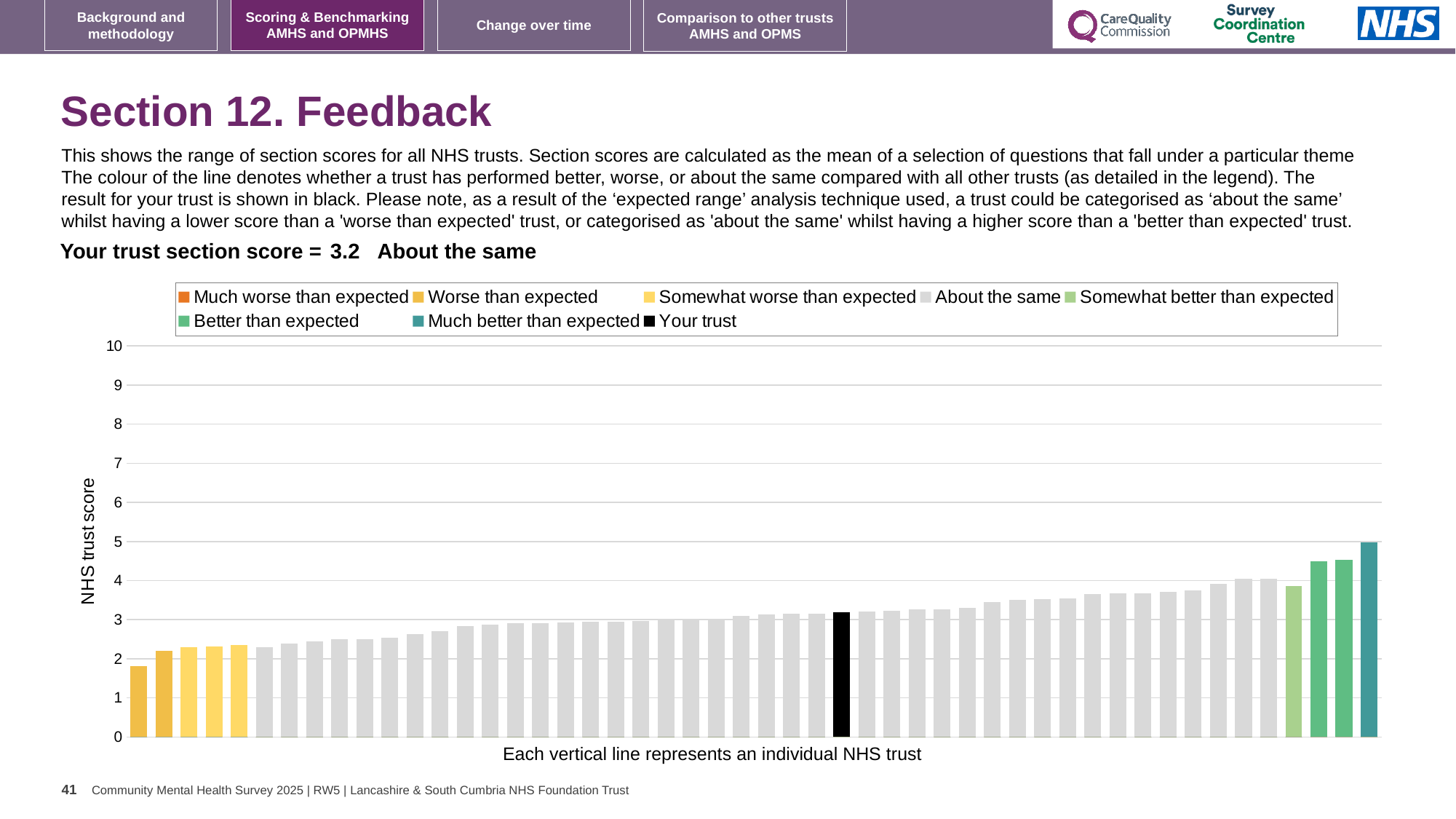
What is the section score for your trust shown on the slide? 3.2 What is the label on the vertical axis of the chart? NHS trust score What colour is used for the 'Your trust' bar in the chart? black Which legend category does the tallest bar in the chart belong to? Much better than expected Which category is your trust placed in for this section? About the same Do the bar values rise or fall from left to right across the chart? rise How many entries does the chart legend list? 8 Is the value of the black 'Your trust' bar greater or less than 3? greater Is the value of the tallest bar in the chart greater or less than 4? greater Is the value of the shortest bar in the chart greater or less than 2? less What kind of chart is shown on the slide? bar chart How many bars are coloured as 'Better than expected' (green)? 2